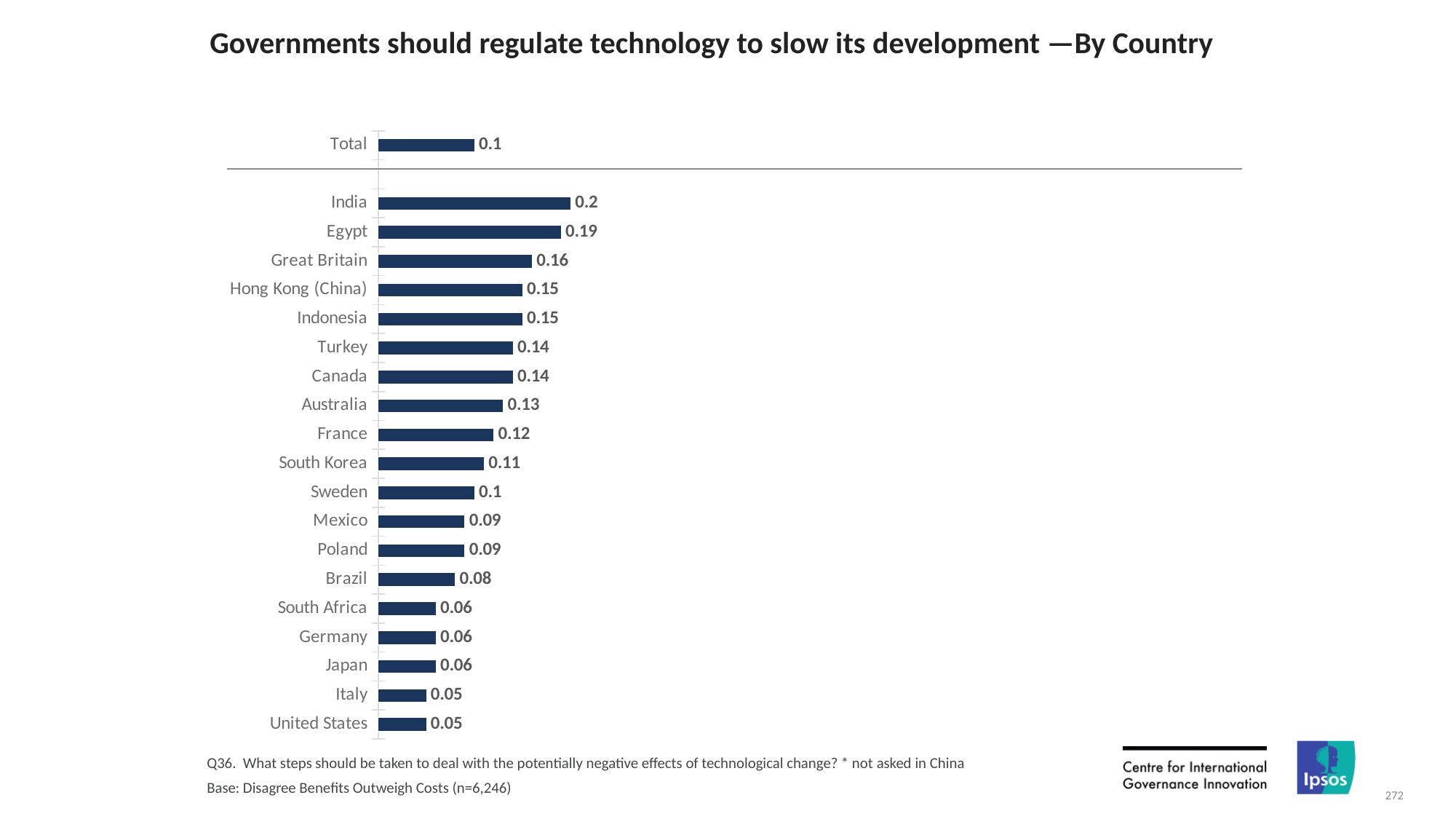
Which country has the highest value? India What kind of chart is shown on the slide? Bar chart What is the value for Total? 0.1 Which is larger, the value for South Korea or the value for Australia? Australia Which is larger, the value for Turkey or the value for France? Turkey What is the title of the chart? Governments should regulate technology to slow its development —By Country How many countries are shown in the chart, excluding Total? 19 What is the value for Great Britain? 0.16 What is the difference between the values for India and Egypt? 0.01 What is the difference between the values for Great Britain and United States? 0.11 What is the value for Brazil? 0.08 What is the value for India? 0.2